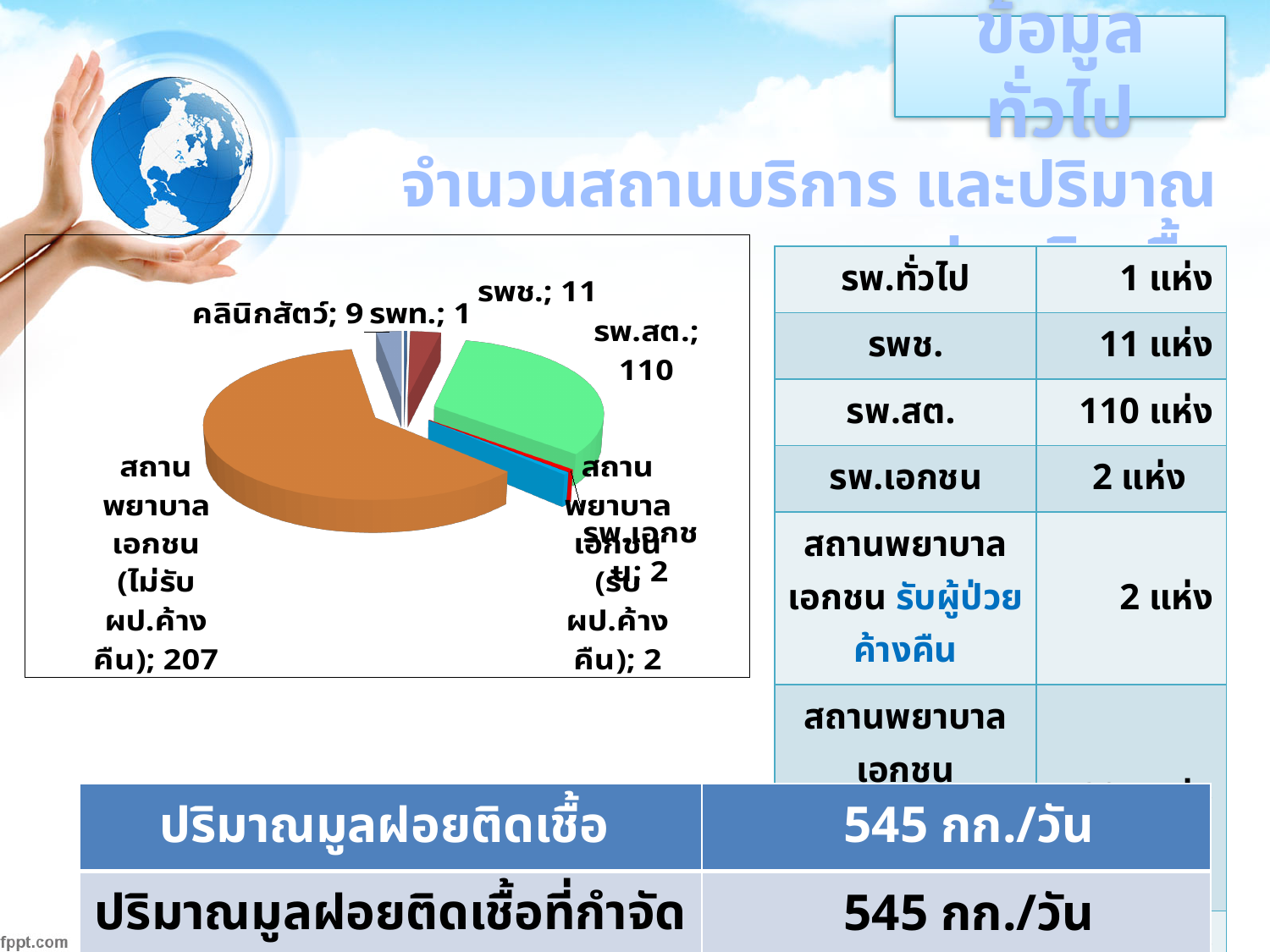
Which is larger in the pie chart, รพช. or คลินิกสัตว์? รพช. What is the value for รพ.สต. in the pie chart? 110 What is the difference between the values for สถานพยาบาลเอกชน (ไม่รับ ผป.ค้างคืน) and รพ.สต. in the pie chart? 97 What is the value for รพช. in the pie chart? 11 What is the value for คลินิกสัตว์ in the pie chart? 9 How many slices does the pie chart have? 7 Which category has the smallest slice in the pie chart? รพท. Which category has the largest slice in the pie chart? สถานพยาบาลเอกชน (ไม่รับ ผป.ค้างคืน) What is the value for สถานพยาบาลเอกชน (ไม่รับ ผป.ค้างคืน) in the pie chart? 207 What kind of chart is shown on the slide? pie chart What is the total of all the values shown in the pie chart? 342 What is the value for รพท. in the pie chart? 1